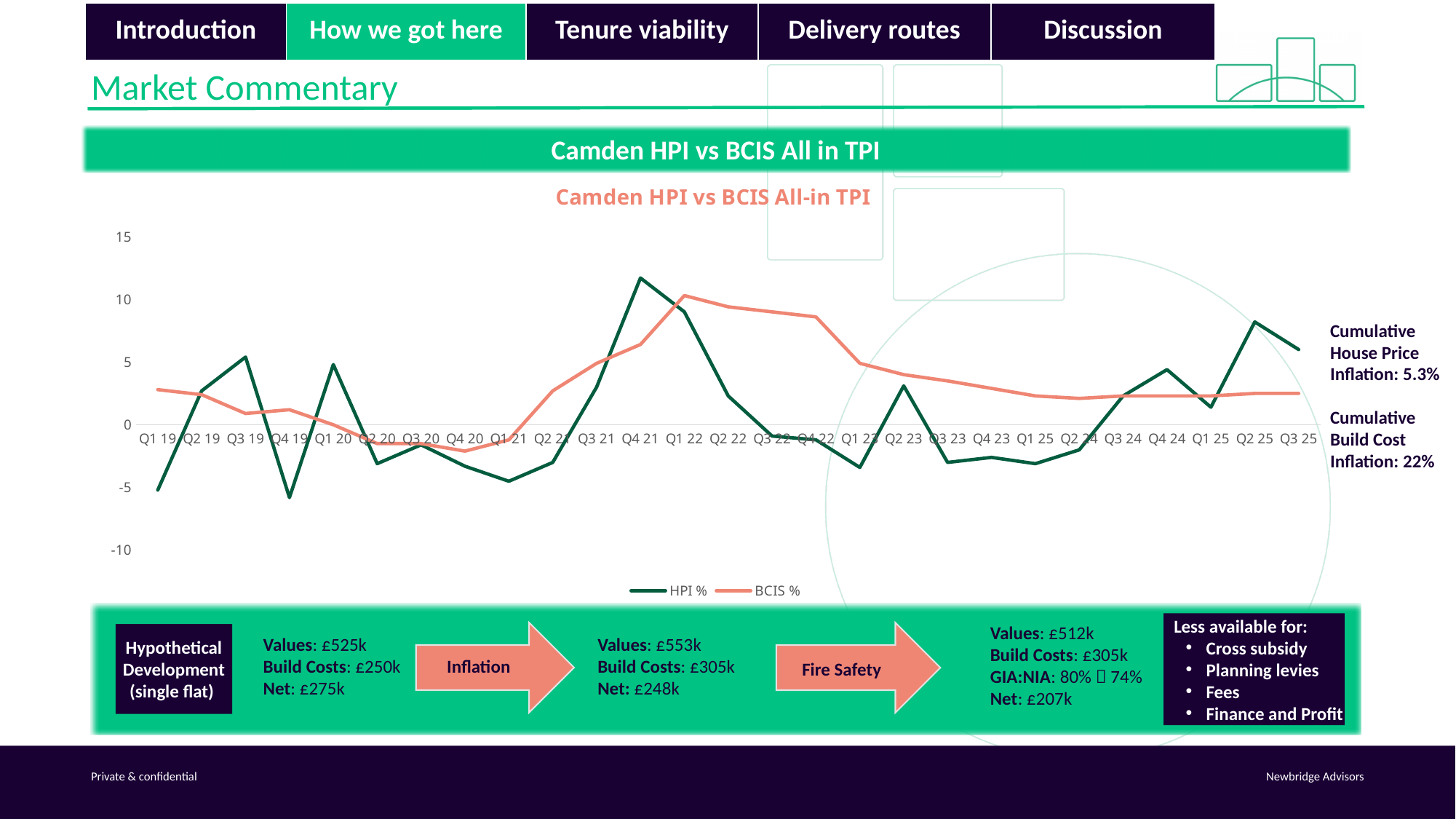
At Q4 22, which series has the higher value, HPI % or BCIS %? BCIS % Is the BCIS % value for Q3 25 greater or less than 5? less How many series does the chart legend list? 2 In which quarter does the BCIS % series reach its highest value? Q1 22 At Q4 21, which series has the higher value, HPI % or BCIS %? HPI % What is the title of the chart? Camden HPI vs BCIS All-in TPI Is the HPI % value for Q1 23 greater or less than 0? less In which quarter does the HPI % series reach its highest value? Q4 21 Is the HPI % value for Q4 21 greater or less than 10? greater What are the two series named in the chart legend? HPI % and BCIS % What kind of chart is shown on the slide? line chart